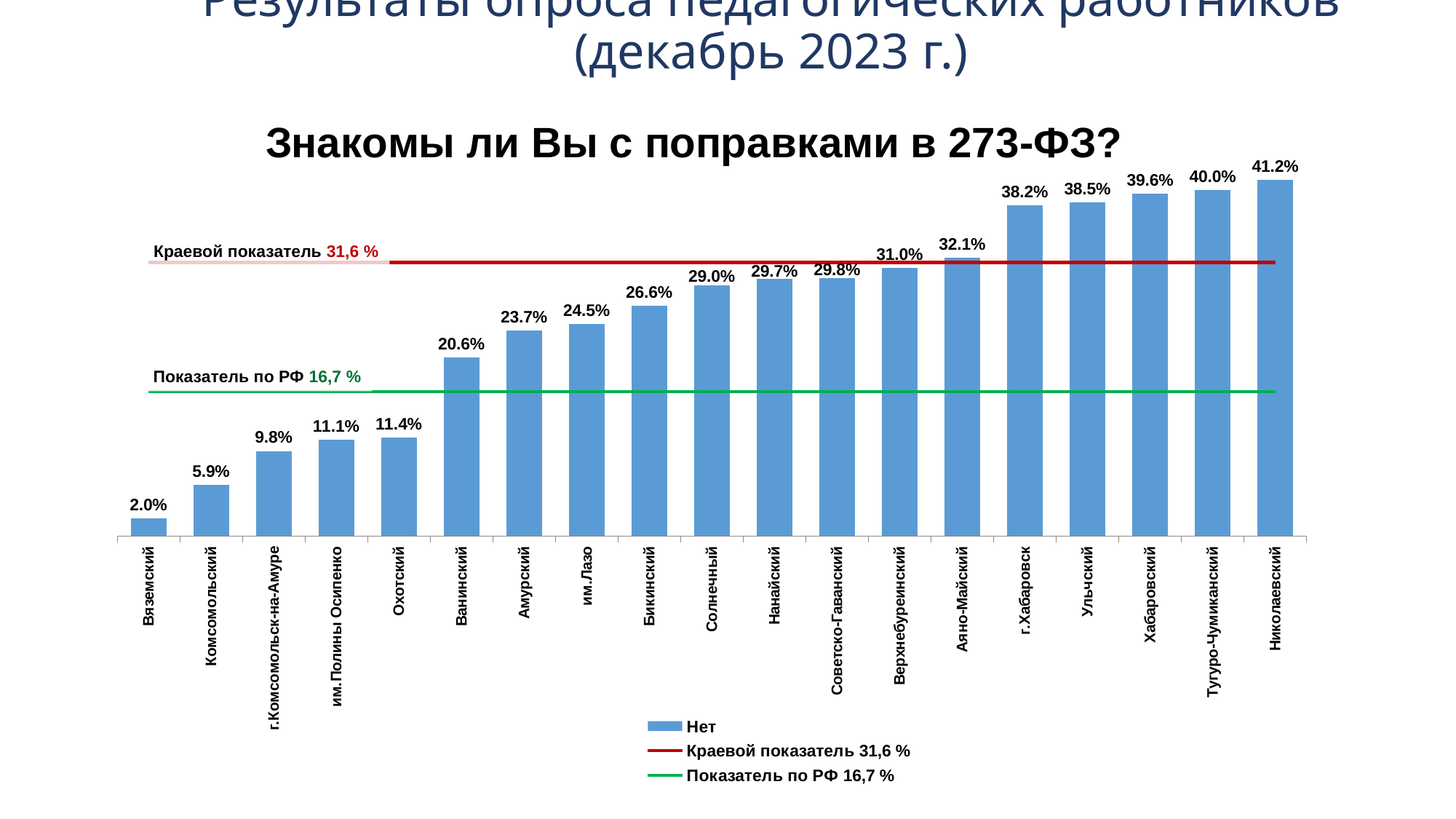
What value does the red reference line (Краевой показатель) represent? 31,6 % How many entries does the legend list? 3 Which category has the highest value? Николаевский What is the value for Ванинский? 20.6% Which category has the lowest value? Вяземский What is the value for г.Хабаровск? 38.2% What kind of chart is this? bar chart How many categories are shown on the x axis? 19 Which is larger, the value for Амурский or the value for Бикинский? Бикинский What is the value for Охотский? 11.4% What is the difference between the values for Тугуро-Чумиканский and Хабаровский? 0.4% What is the difference between the values for Николаевский and Вяземский? 39.2%